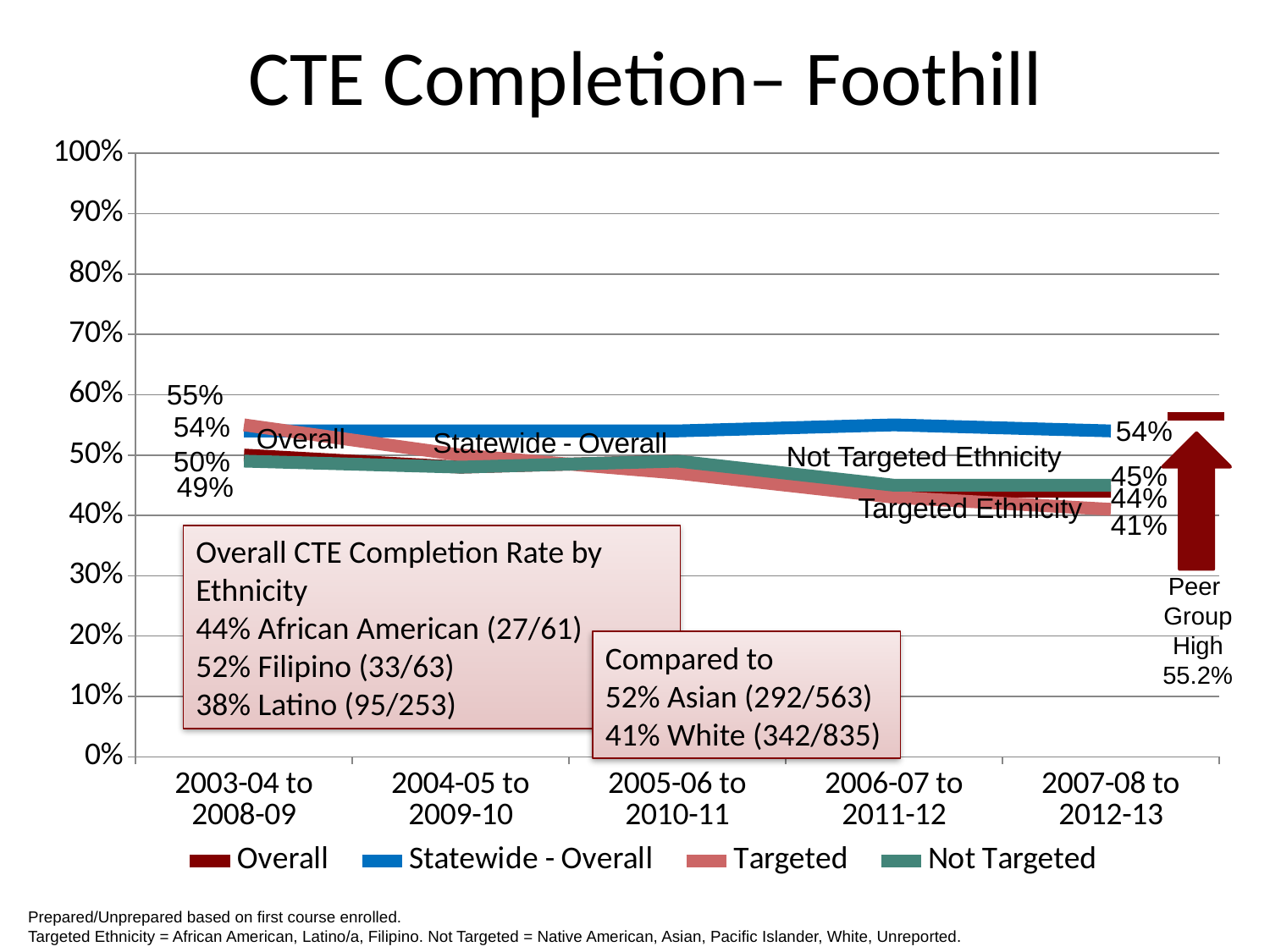
How many series does the legend list? 4 What Peer Group High value is shown next to the chart? 55.2% Which series has the highest value for the 2007-08 to 2012-13 cohort? Statewide - Overall Does the Targeted series rise or fall from the first cohort to the last cohort? Fall What is the Targeted CTE completion rate for the 2007-08 to 2012-13 cohort? 41% What type of chart is shown on the slide? Line chart For the 2007-08 to 2012-13 cohort, which is larger: the Not Targeted rate or the Targeted rate? Not Targeted What is the Statewide - Overall CTE completion rate for the 2007-08 to 2012-13 cohort? 54% What is the difference between the Statewide - Overall rate and the Targeted rate for the 2007-08 to 2012-13 cohort? 13 percentage points Which series has the lowest value for the 2007-08 to 2012-13 cohort? Targeted How many cohort periods are shown on the x axis? 5 Is the Targeted value for the 2007-08 to 2012-13 cohort greater or less than 50%? less